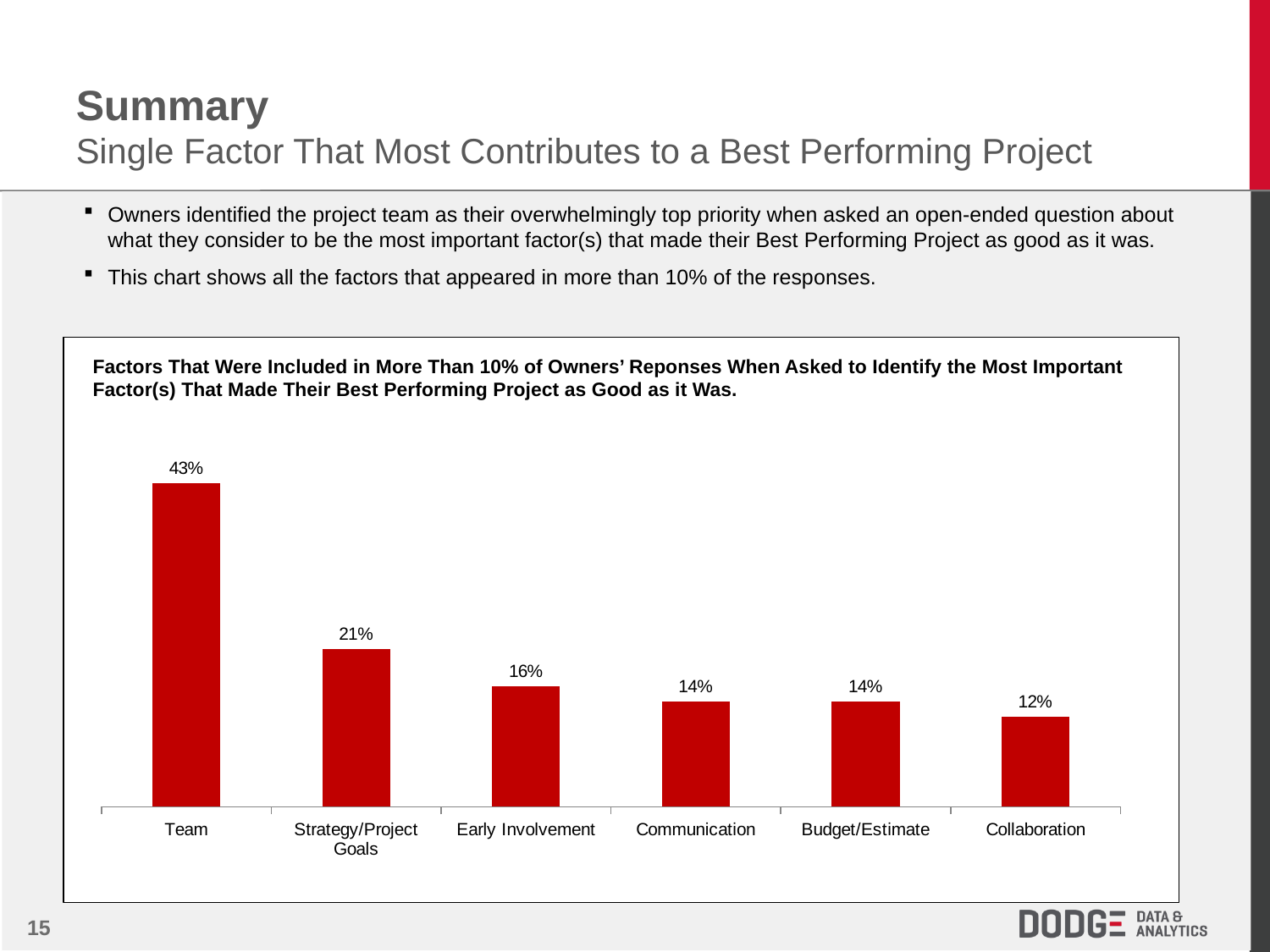
What kind of chart is shown on the slide? Bar chart Which has a larger value, Strategy/Project Goals or Early Involvement? Strategy/Project Goals What is the difference between the values for Team and Strategy/Project Goals? 22% What is the value shown for Strategy/Project Goals? 21% Which factor has the highest value in the chart? Team What percentage of owners' responses included Team as a factor? 43% Do the values rise or fall moving from left to right across the chart? Fall What is the value shown for Collaboration? 12% What is the value shown for Early Involvement? 16% Which factor has the lowest value in the chart? Collaboration How many factors are shown in the chart? 6 What is the difference between the values for Early Involvement and Collaboration? 4%